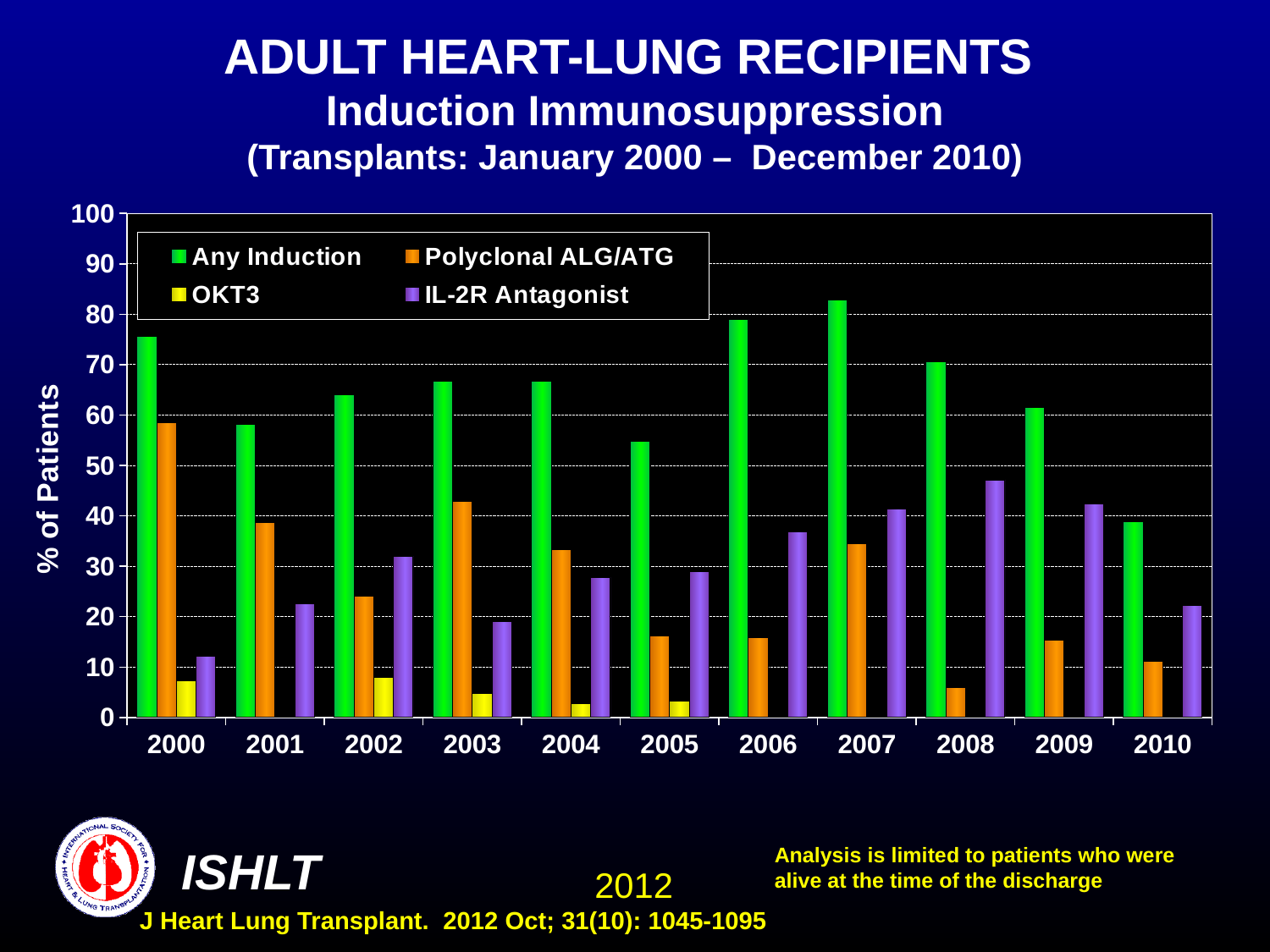
Is the Any Induction value for 2007 greater or less than 80? greater In which year is the Any Induction value highest? 2007 Does the IL-2R Antagonist value generally rise or fall from 2000 to 2008? rise What kind of chart is shown on the slide? bar chart Is the Polyclonal ALG/ATG value for 2008 greater or less than 10? less In which year is the Any Induction value lowest? 2010 In which year is the Polyclonal ALG/ATG value highest? 2000 What is the label on the y axis? % of Patients How many series does the legend list? 4 In 2000, which is larger: Polyclonal ALG/ATG or IL-2R Antagonist? Polyclonal ALG/ATG In which year is the IL-2R Antagonist value lowest? 2000 How many years are shown along the x axis? 11